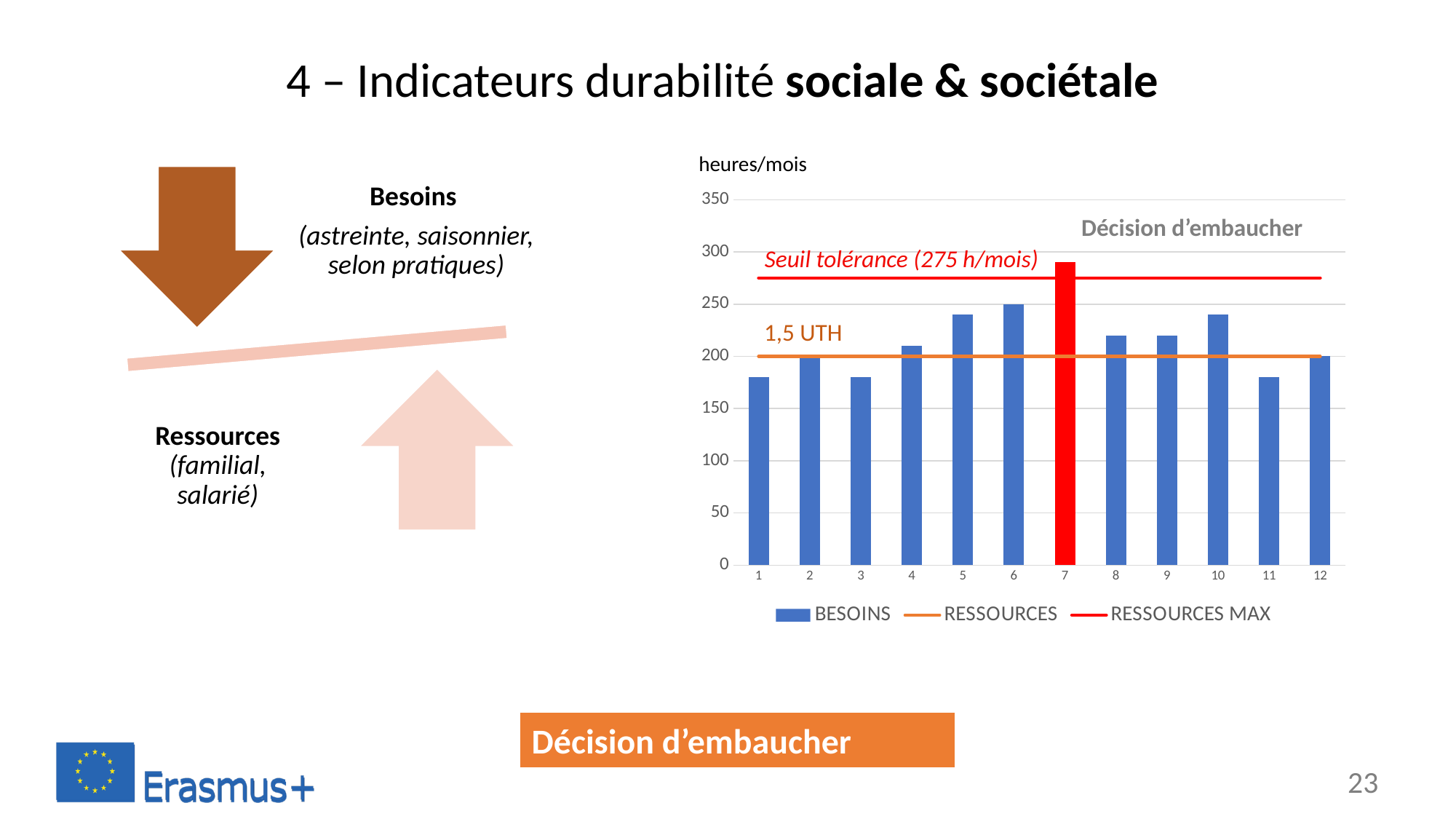
Which is larger, the BESOINS value for month 6 or for month 11? month 6 Which month has the highest BESOINS bar? 7 What is the BESOINS value for month 6? 250 What unit label is shown above the chart's vertical axis? heures/mois Is the BESOINS value for month 5 greater or less than 200? greater Is the BESOINS value for month 1 greater or less than 200? less What value does the RESSOURCES MAX line (Seuil tolérance) correspond to? 275 h/mois Which series in the legend is drawn as a red line? RESSOURCES MAX What kind of chart is shown on the slide? combination bar and line chart How many categories (months) are shown on the x axis of the chart? 12 Is the BESOINS value for month 7 greater or less than 250? greater How many series does the chart legend list? 3